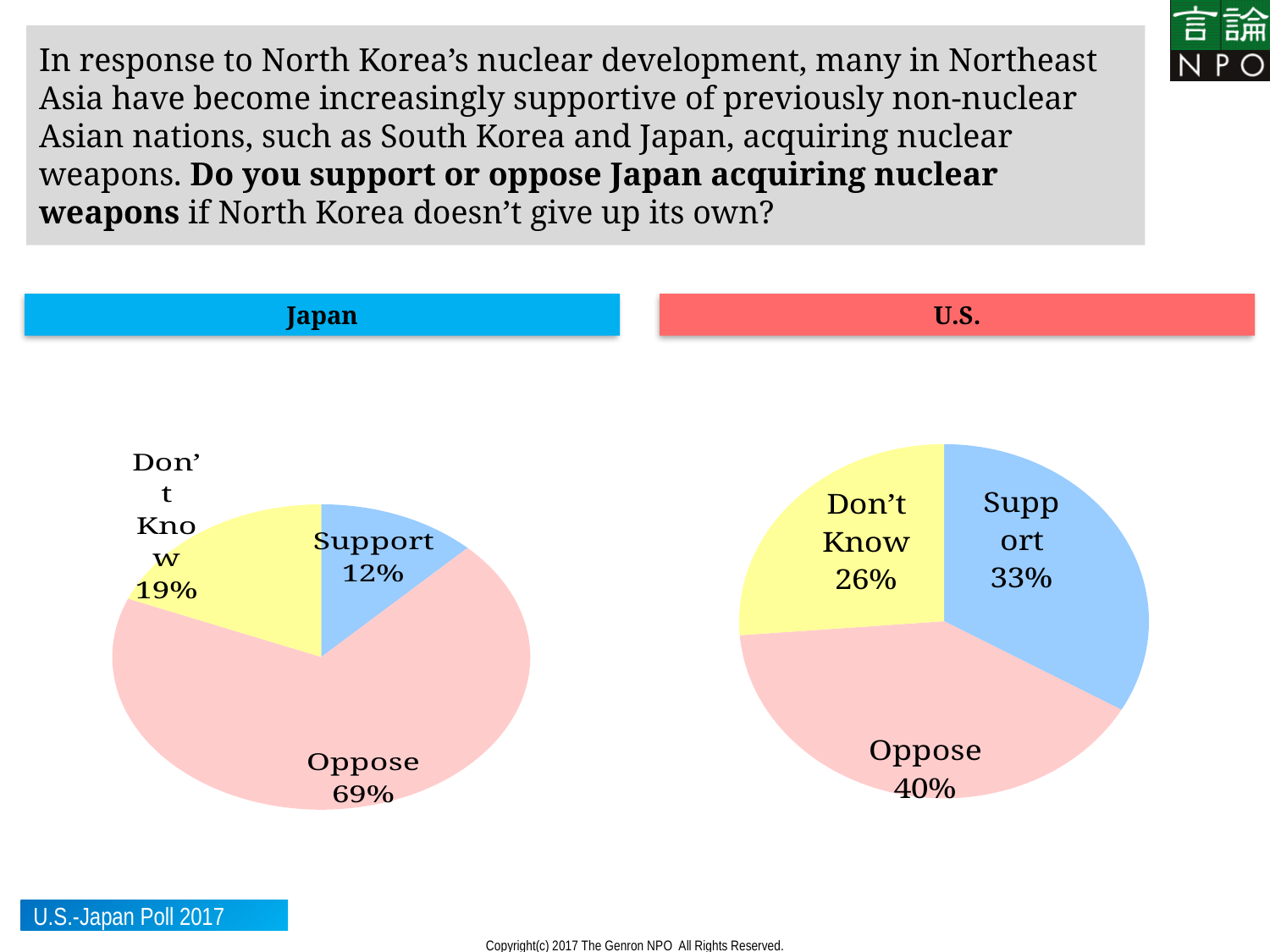
In the Japan pie chart, what percentage of respondents oppose Japan acquiring nuclear weapons? 69% In the U.S. pie chart, what percentage of respondents support Japan acquiring nuclear weapons? 33% What is the difference between the Oppose share in the Japan chart and the Oppose share in the U.S. chart? 29 percentage points How many slices does the U.S. pie chart have? 3 In the Japan pie chart, what is the value for Don't Know? 19% In the Japan pie chart, which response has the smallest share? Support In the U.S. pie chart, which response has the smallest share? Don't Know In the U.S. pie chart, what colour is the Oppose slice? Pink In the U.S. pie chart, what is the value for Don't Know? 26% Which is larger: the Support share in the Japan chart or the Support share in the U.S. chart? U.S. In the Japan pie chart, which response has the largest share? Oppose What type of chart is used to show the Japan results? Pie chart